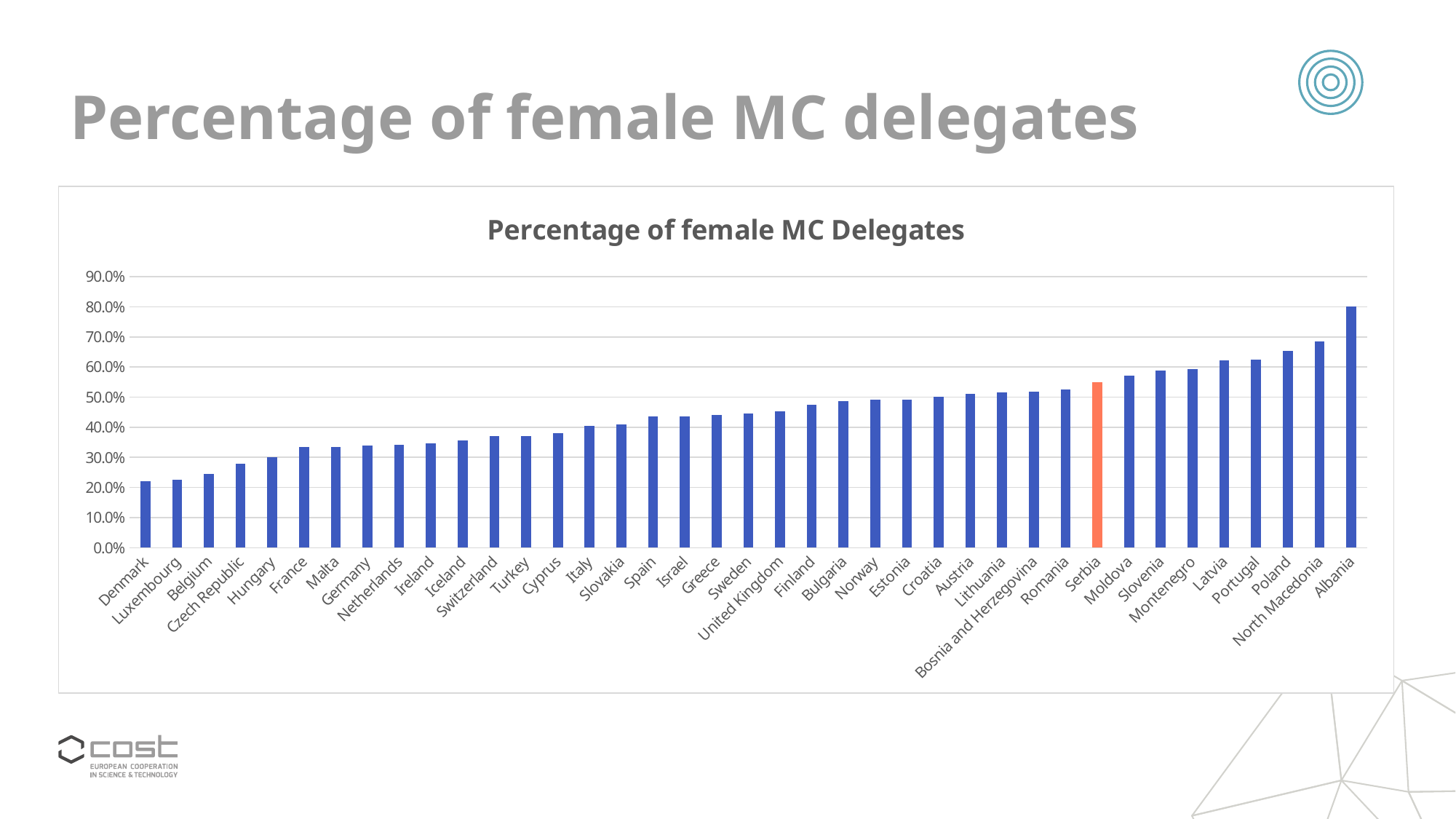
Which country has the lowest percentage of female MC delegates? Denmark Do the values rise or fall moving from left to right along the x axis? Rise Which country's bar is highlighted in orange? Serbia Is the value for Serbia greater or less than 50.0%? greater Is the value for Spain greater or less than 50.0%? less What kind of chart is shown on the slide? Bar chart Which country has the highest percentage of female MC delegates? Albania Is the value for Denmark greater or less than 30.0%? less What is the title of the chart? Percentage of female MC Delegates Which has a higher percentage of female MC delegates, Albania or North Macedonia? Albania How many countries are shown on the x axis of the chart? 39